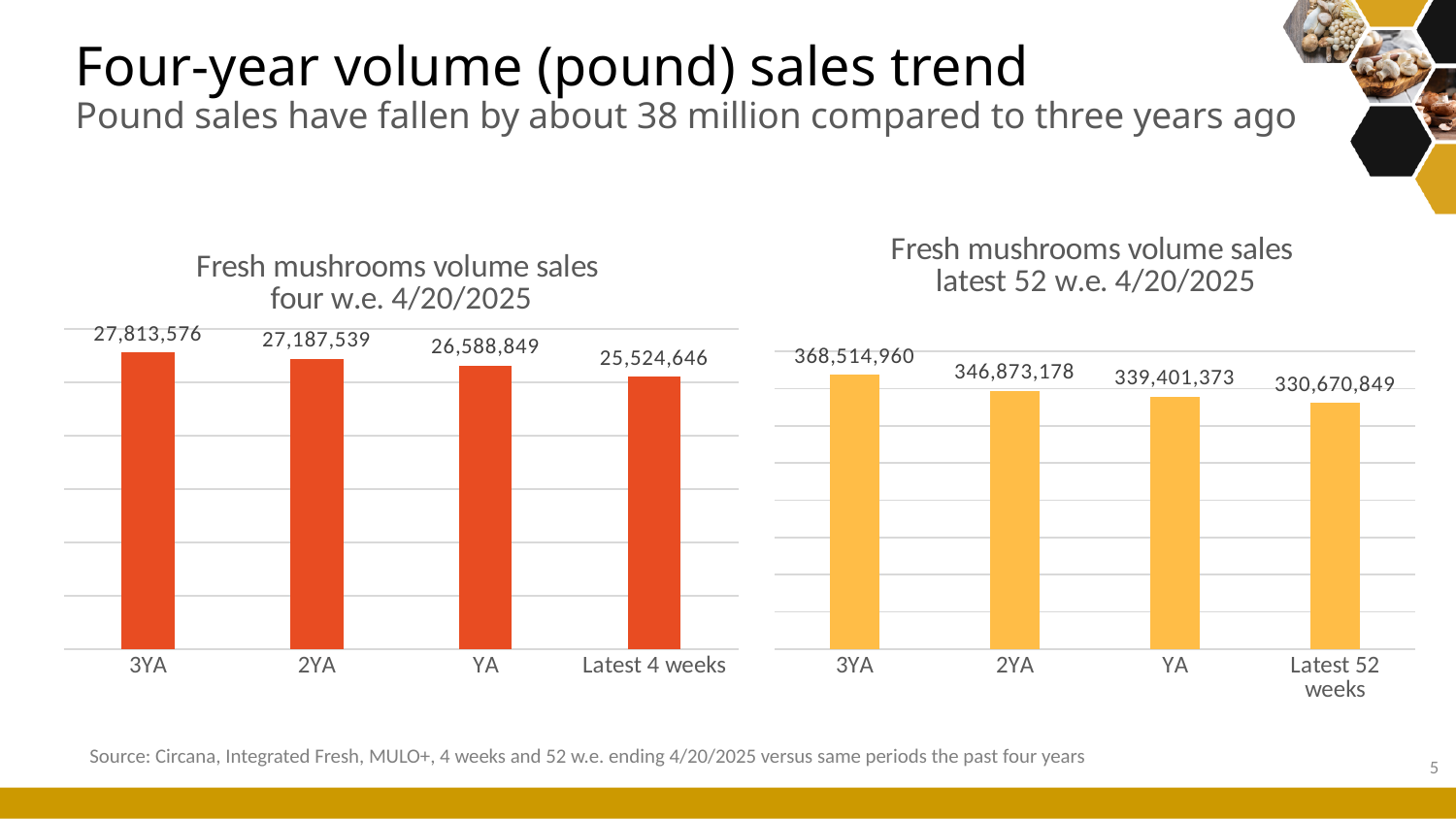
In the 'Fresh mushrooms volume sales four w.e. 4/20/2025' chart, what is the difference between the 3YA value and the Latest 4 weeks value? 2,288,930 In the 'Fresh mushrooms volume sales four w.e. 4/20/2025' chart, do the values rise or fall from 3YA to Latest 4 weeks? Fall In the 'Fresh mushrooms volume sales four w.e. 4/20/2025' chart, which period has the highest value? 3YA In the 'Fresh mushrooms volume sales four w.e. 4/20/2025' chart, what is the value for 3YA? 27,813,576 In the 'Fresh mushrooms volume sales latest 52 w.e. 4/20/2025' chart, what is the value for 2YA? 346,873,178 How many bars are in the 'Fresh mushrooms volume sales four w.e. 4/20/2025' chart? 4 In the 'Fresh mushrooms volume sales latest 52 w.e. 4/20/2025' chart, what is the difference between the 3YA value and the Latest 52 weeks value? 37,844,111 In the 'Fresh mushrooms volume sales latest 52 w.e. 4/20/2025' chart, which is larger, the value for 2YA or the value for YA? 2YA What type of chart is the 'Fresh mushrooms volume sales latest 52 w.e. 4/20/2025' chart? Bar chart In the 'Fresh mushrooms volume sales latest 52 w.e. 4/20/2025' chart, what is the value for Latest 52 weeks? 330,670,849 In the 'Fresh mushrooms volume sales latest 52 w.e. 4/20/2025' chart, which period has the lowest value? Latest 52 weeks In the 'Fresh mushrooms volume sales four w.e. 4/20/2025' chart, what is the value for Latest 4 weeks? 25,524,646